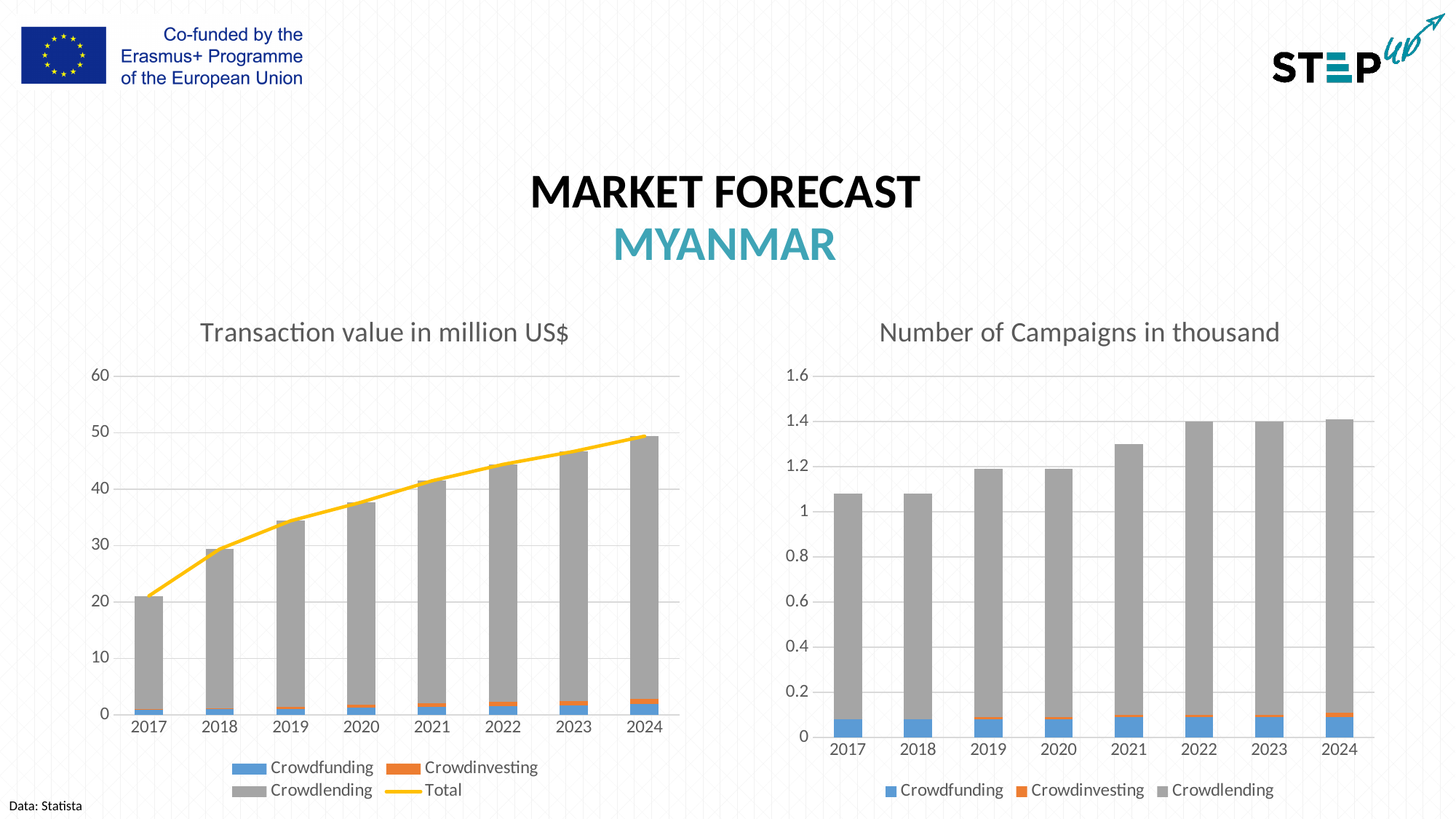
In the 'Number of Campaigns in thousand' chart, how many series does the legend list? 3 In the 'Transaction value in million US$' chart, is the total value for 2021 greater or less than 40? greater In the 'Transaction value in million US$' chart, is the total value for 2019 greater or less than 30? greater In the 'Transaction value in million US$' chart, which year has a larger total transaction value, 2020 or 2023? 2023 In the 'Transaction value in million US$' chart, how many entries does the legend list? 4 In the 'Number of Campaigns in thousand' chart, is the total for 2021 greater or less than 1.2? greater In the 'Transaction value in million US$' chart, which year has the highest total transaction value? 2024 What kind of chart is the 'Number of Campaigns in thousand' chart? stacked bar chart In the 'Transaction value in million US$' chart, how many years are shown on the x axis? 8 In the 'Transaction value in million US$' chart, does the Total line rise or fall from 2017 to 2024? rise In the 'Number of Campaigns in thousand' chart, which year has a larger total, 2019 or 2021? 2021 In the 'Transaction value in million US$' chart, which year has the lowest total transaction value? 2017